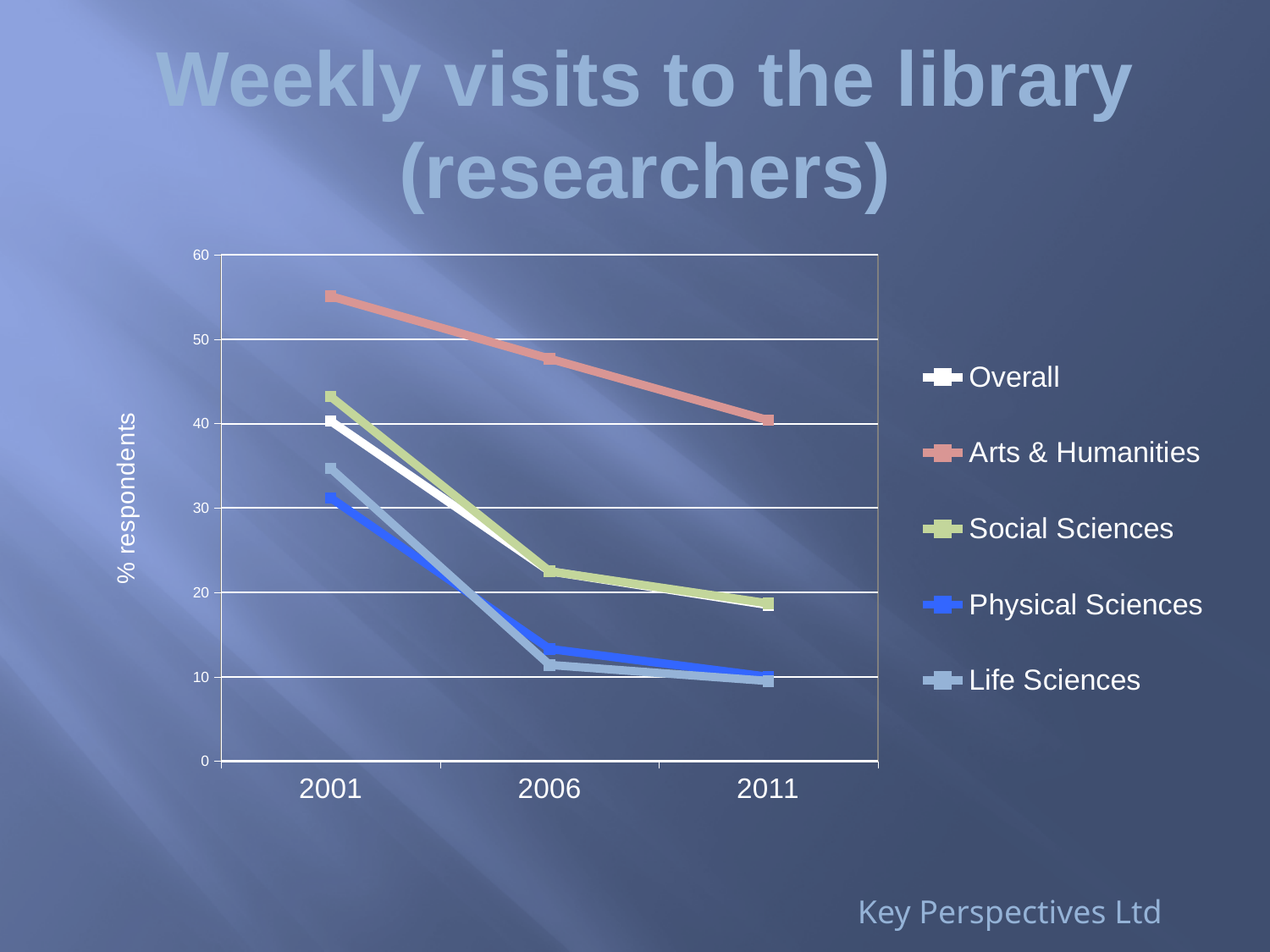
In 2006, which is larger: Arts & Humanities or Social Sciences? Arts & Humanities Is the value for Arts & Humanities in 2001 greater or less than 50? greater What kind of chart is shown on the slide? line chart Which series has the highest value in 2001? Arts & Humanities How many series does the legend list? 5 Which series has the lowest value in 2001? Physical Sciences Is the value for Physical Sciences in 2006 greater or less than 10? greater How many years are plotted along the x axis? 3 Does the Arts & Humanities line rise or fall from 2001 to 2011? fall Is the value for Life Sciences in 2001 greater or less than 30? greater What is the label on the y axis? % respondents What is the title of the chart? Weekly visits to the library (researchers)